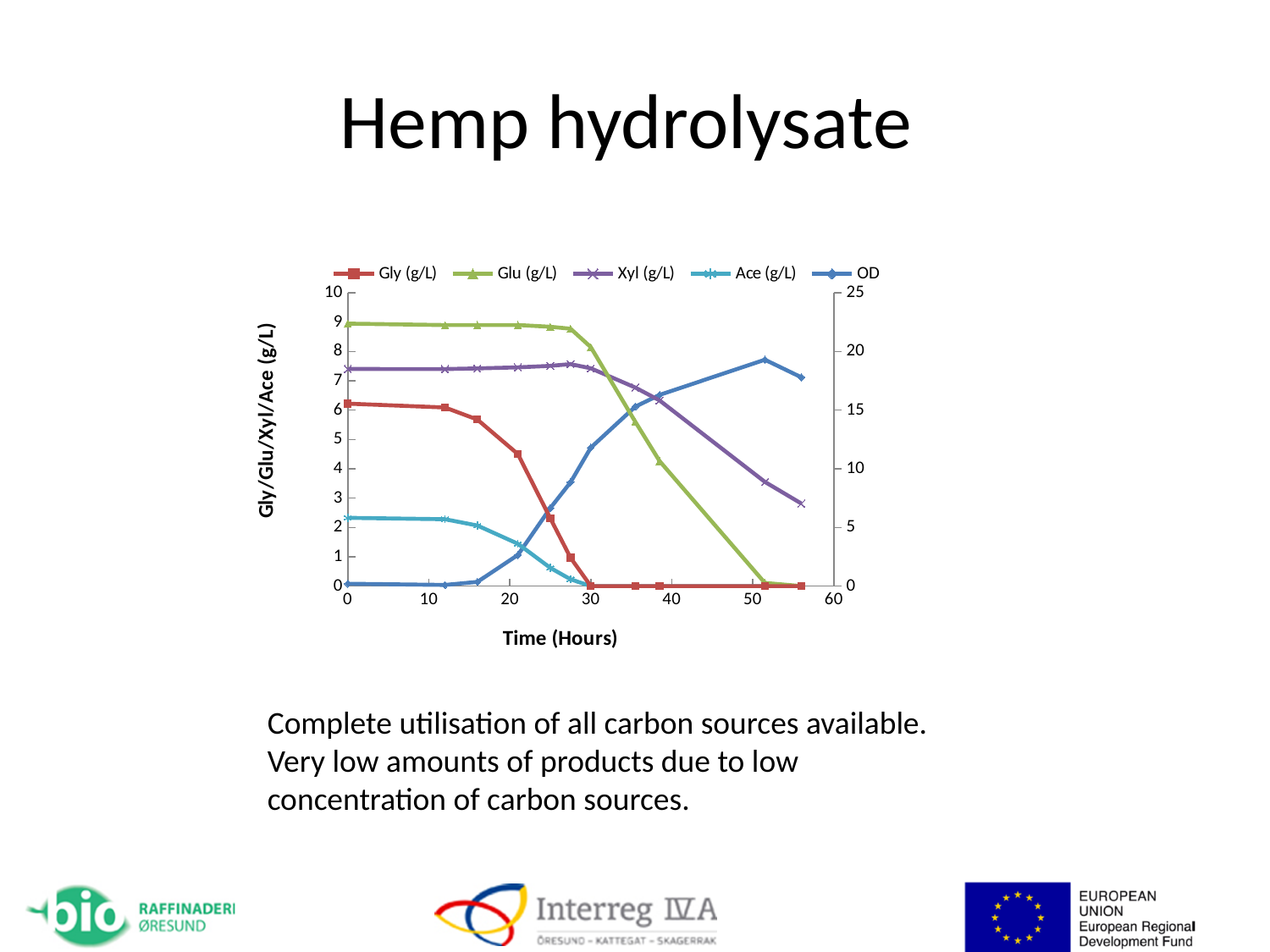
What is the title of the x axis? Time (Hours) Does the Glu (g/L) series rise or fall between 30 and 50 hours? fall Which series has the highest value at time 0 on the left axis? Glu (g/L) At time 0, which is larger: Glu (g/L) or Xyl (g/L)? Glu (g/L) Which series is plotted on the secondary (right-hand) axis? OD Is the value for Ace (g/L) at time 0 greater or less than 3? less What kind of chart is shown on the slide? line chart Which series has the lowest value at time 0 on the left axis? Ace (g/L) Is the value for Glu (g/L) at time 0 greater or less than 8? greater How many series does the chart legend list? 5 Does the Gly (g/L) series rise or fall over time? fall Does the OD series rise or fall between 0 and 50 hours? rise